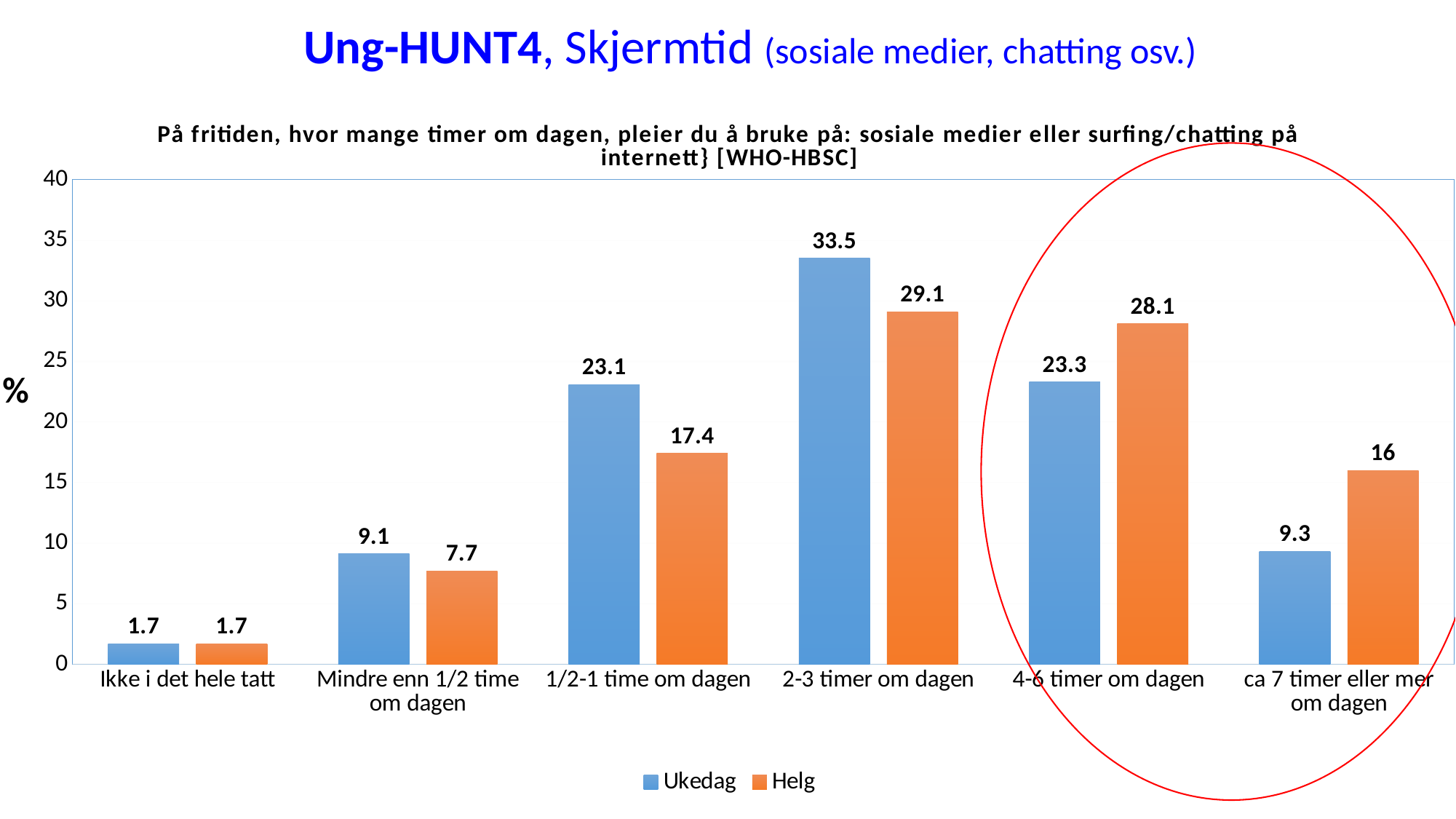
Which category has the lowest Helg value? Ikke i det hele tatt How many categories are shown on the x axis? 6 For '4-6 timer om dagen', which series has the larger value, Ukedag or Helg? Helg What kind of chart is shown on the slide? bar chart What is the difference between the Ukedag and Helg values for '1/2-1 time om dagen'? 5.7 Which colour represents the Helg series? orange Is the Ukedag value for 'ca 7 timer eller mer om dagen' greater or less than 10? less How many series does the legend list? 2 What is the Ukedag value for '2-3 timer om dagen'? 33.5 What is the Helg value for 'ca 7 timer eller mer om dagen'? 16 What is the Helg value for '4-6 timer om dagen'? 28.1 Which category has the highest Ukedag value? 2-3 timer om dagen